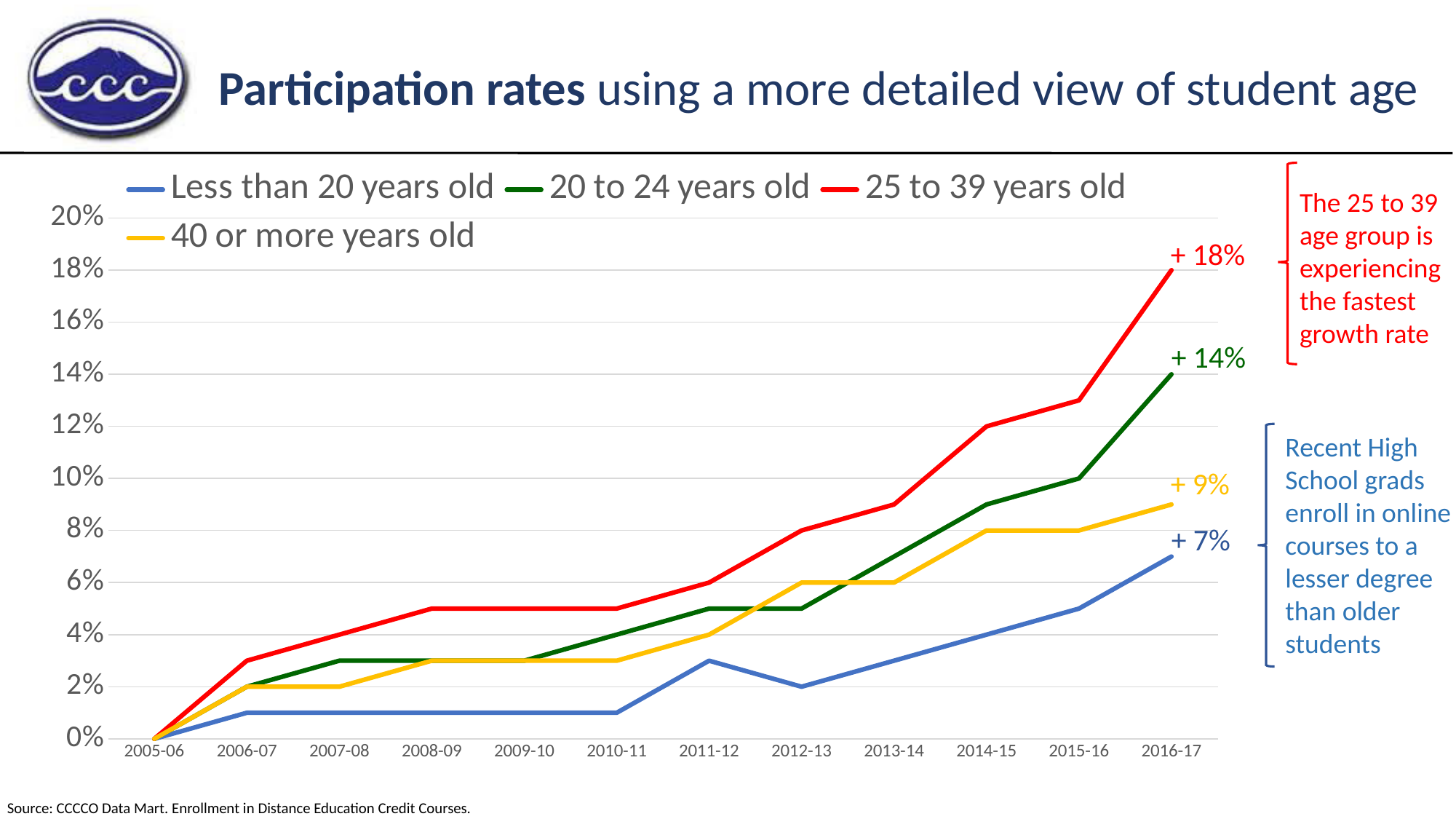
Which age group has the highest participation rate in 2016-17? 25 to 39 years old How many academic years are shown along the x axis? 12 What kind of chart is shown on the slide? line chart What is the difference between the 2016-17 values for 25 to 39 years old and Less than 20 years old? 11% What value is labelled for the Less than 20 years old series in 2016-17? + 7% In 2016-17, which is larger: the value for 20 to 24 years old or for 40 or more years old? 20 to 24 years old Does the participation rate for 25 to 39 years old rise or fall from 2005-06 to 2016-17? rise What value is labelled for the 25 to 39 years old series in 2016-17? + 18% Is the value for 25 to 39 years old in 2014-15 greater or less than 10%? greater What colour is the line for the 40 or more years old series? yellow How many series does the legend list? 4 Which age group has the lowest participation rate in 2016-17? Less than 20 years old